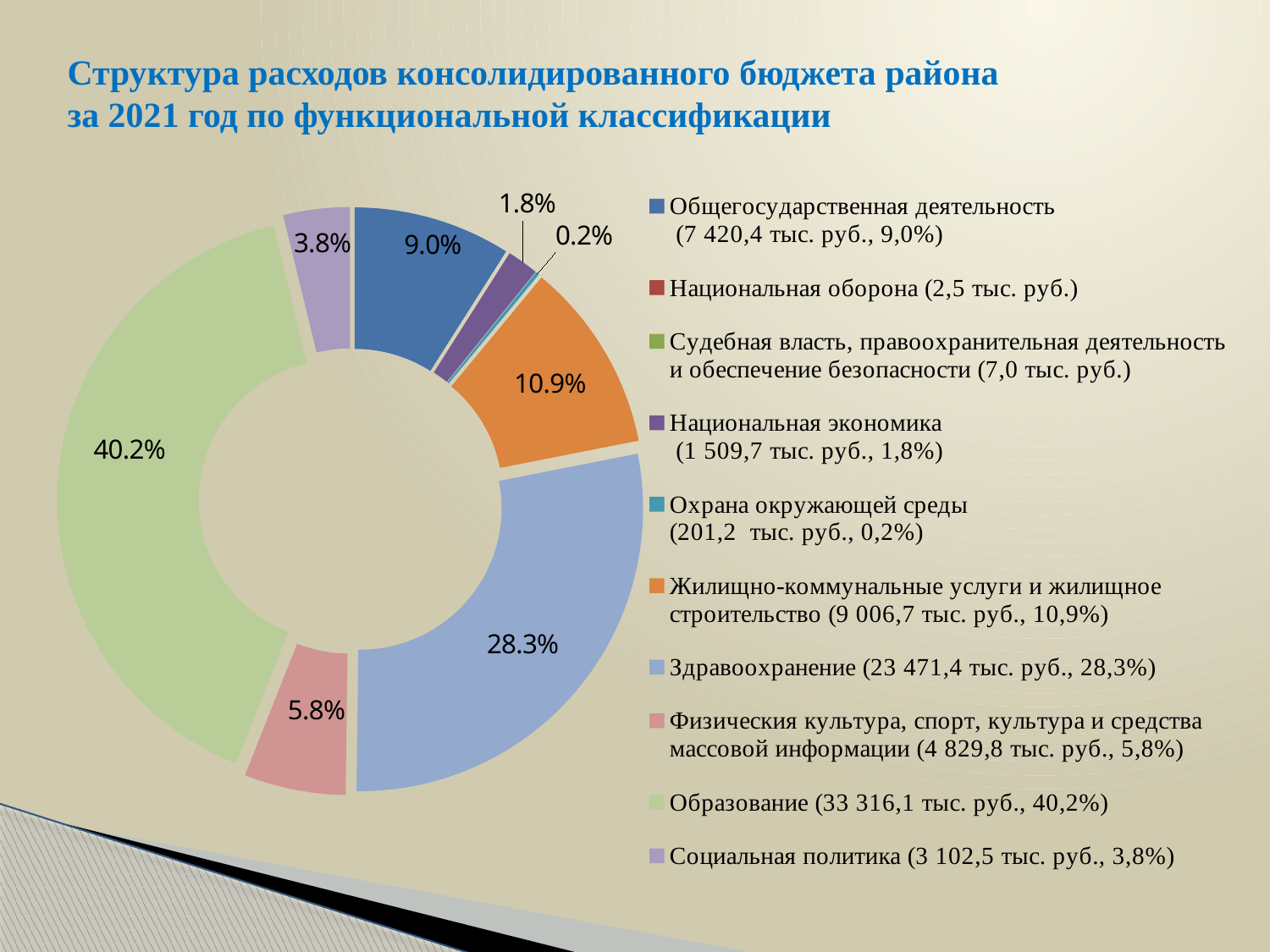
What is the combined share of Образование and Здравоохранение? 68.5% Which category has the largest share of expenditure? Образование How many categories does the legend list? 10 What share is shown for Жилищно-коммунальные услуги и жилищное строительство? 10.9% What share of expenditure does Образование account for? 40.2% What kind of chart is shown on the slide? doughnut chart Which is larger: the share for Здравоохранение or for Жилищно-коммунальные услуги и жилищное строительство? Здравоохранение By how many percentage points does the share for Образование exceed the share for Здравоохранение? 11.9 percentage points According to the legend, what amount in тыс. руб. is spent on Здравоохранение? 23 471,4 тыс. руб. What share of expenditure does Здравоохранение account for? 28.3% What share is shown for Социальная политика? 3.8% What colour is the Образование slice of the chart? light green